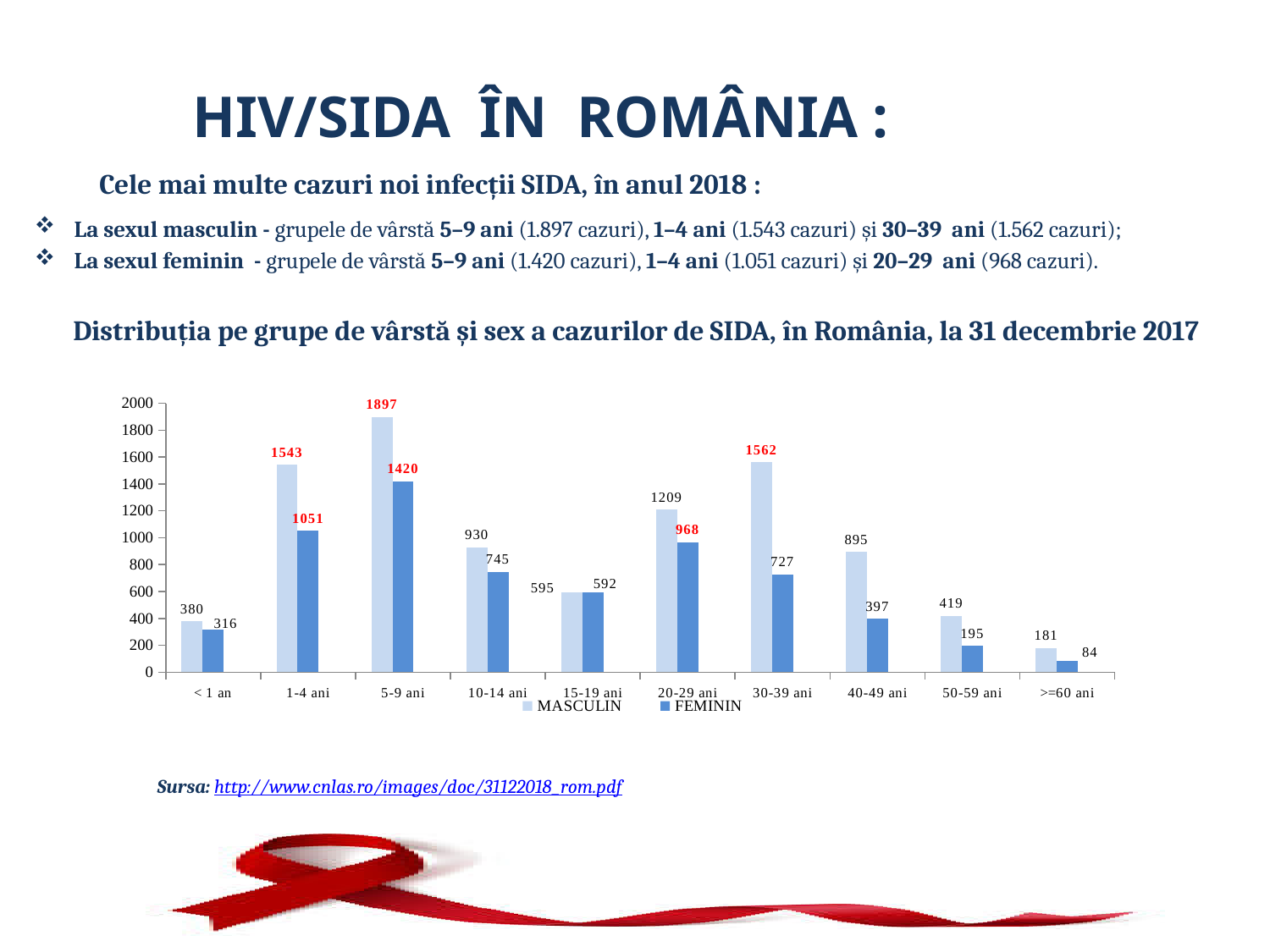
What is the FEMININ value for the 20-29 ani age group? 968 Which age group has the highest MASCULIN value? 5-9 ani What kind of chart is shown on the slide? bar chart What are the two series named in the legend? MASCULIN and FEMININ How many age groups are shown on the x axis? 10 Do the FEMININ values rise or fall from the 30-39 ani group to the >=60 ani group? fall How many series does the legend list? 2 Which age group has the lowest FEMININ value? >=60 ani What is the difference between the MASCULIN and FEMININ values for the 30-39 ani age group? 835 What is the MASCULIN value for the 40-49 ani age group? 895 What is the MASCULIN value for the 5-9 ani age group? 1897 Which is larger for the 15-19 ani age group, the MASCULIN value or the FEMININ value? MASCULIN